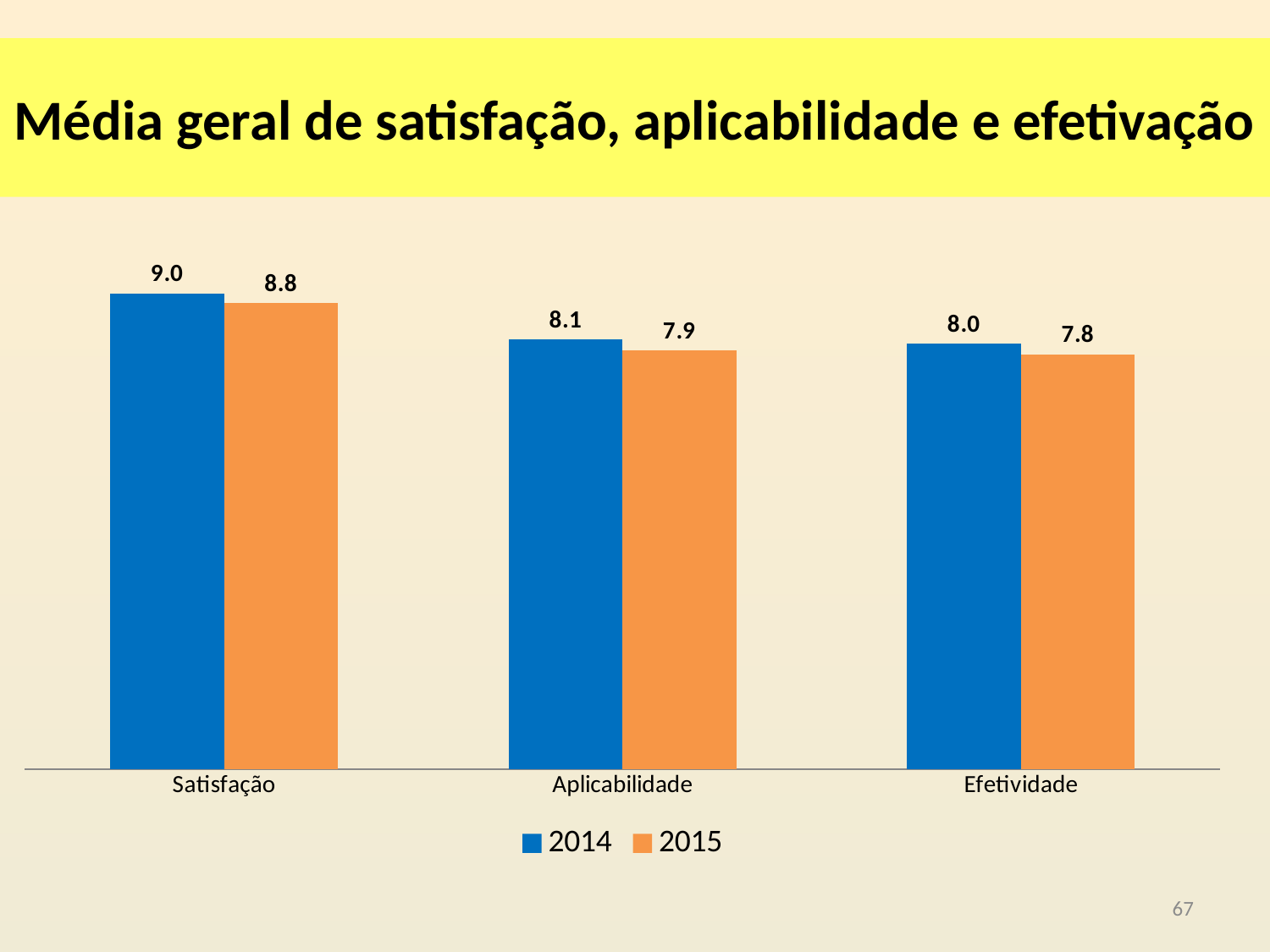
What is the value for Satisfação in 2014? 9.0 What kind of chart is shown on the slide? Bar chart Which colour represents the 2015 series? Orange What is the value for Efetividade in 2014? 8.0 How many series does the legend list? 2 What is the value for Efetividade in 2015? 7.8 How many categories are shown on the x axis? 3 Which category has the lowest value in 2014? Efetividade Which is larger, the 2014 value for Aplicabilidade or the 2015 value for Aplicabilidade? 2014 What is the difference between the 2014 and 2015 values for Satisfação? 0.2 What is the value for Aplicabilidade in 2015? 7.9 Which category has the highest value in 2015? Satisfação